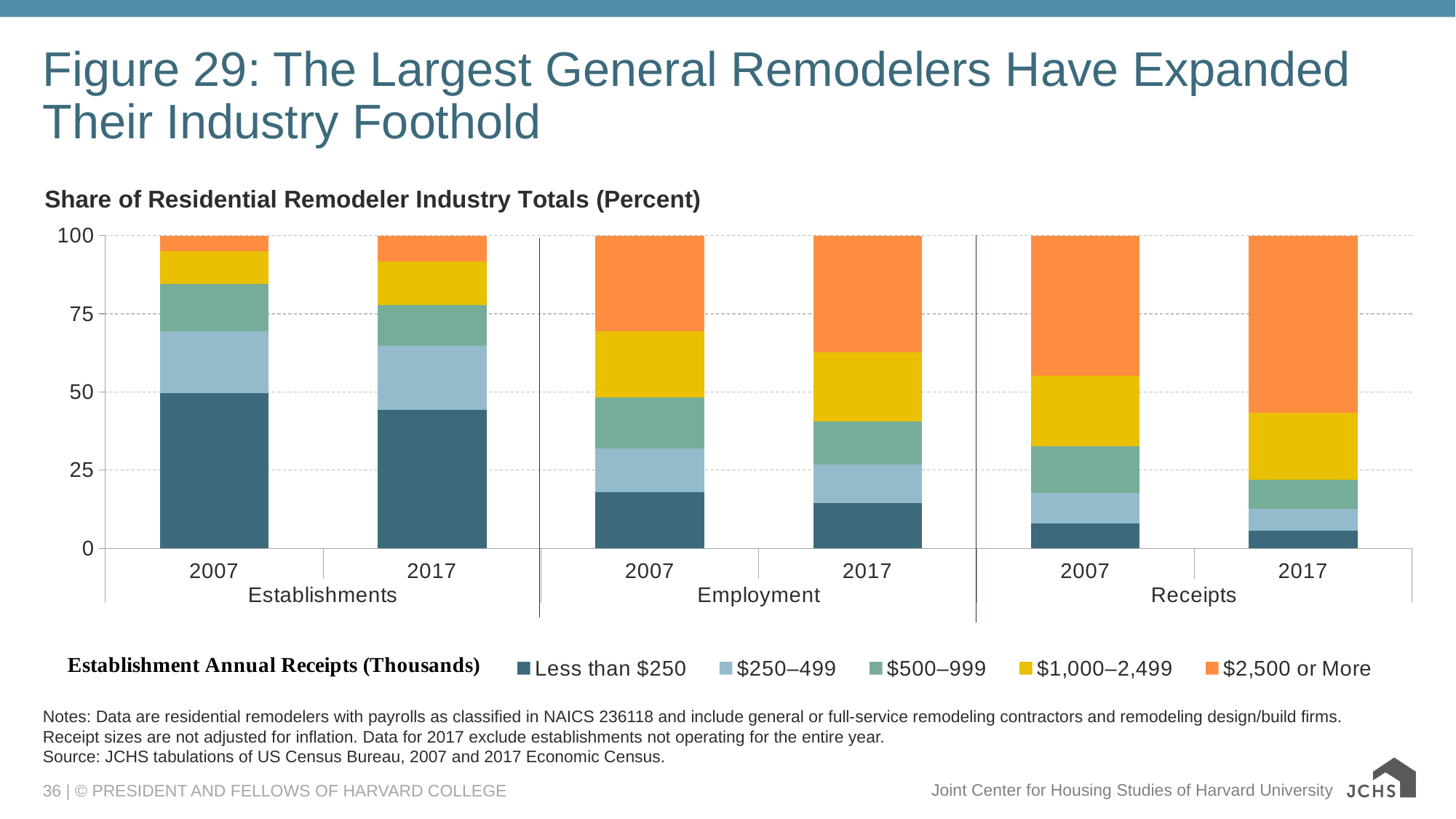
From 2007 to 2017, does the '$2,500 or More' share rise or fall in each of the three groups? Rise For Receipts, is the '$2,500 or More' share larger in 2007 or in 2017? 2017 What kind of chart is shown on the slide? Stacked bar chart In 2007, is the 'Less than $250' share larger for Establishments or for Receipts? Establishments What is the total height of each stacked bar, as read from the axis? 100 How many bars are plotted in the chart? 6 Is the 'Less than $250' share of Employment in 2007 greater or less than 25? less What is the label given to the legend categories below the chart? Establishment Annual Receipts (Thousands) Is the '$2,500 or More' share of Employment in 2017 greater or less than 25? greater Is the 'Less than $250' share of Establishments in 2017 greater or less than 50? less How many series does the legend list? 5